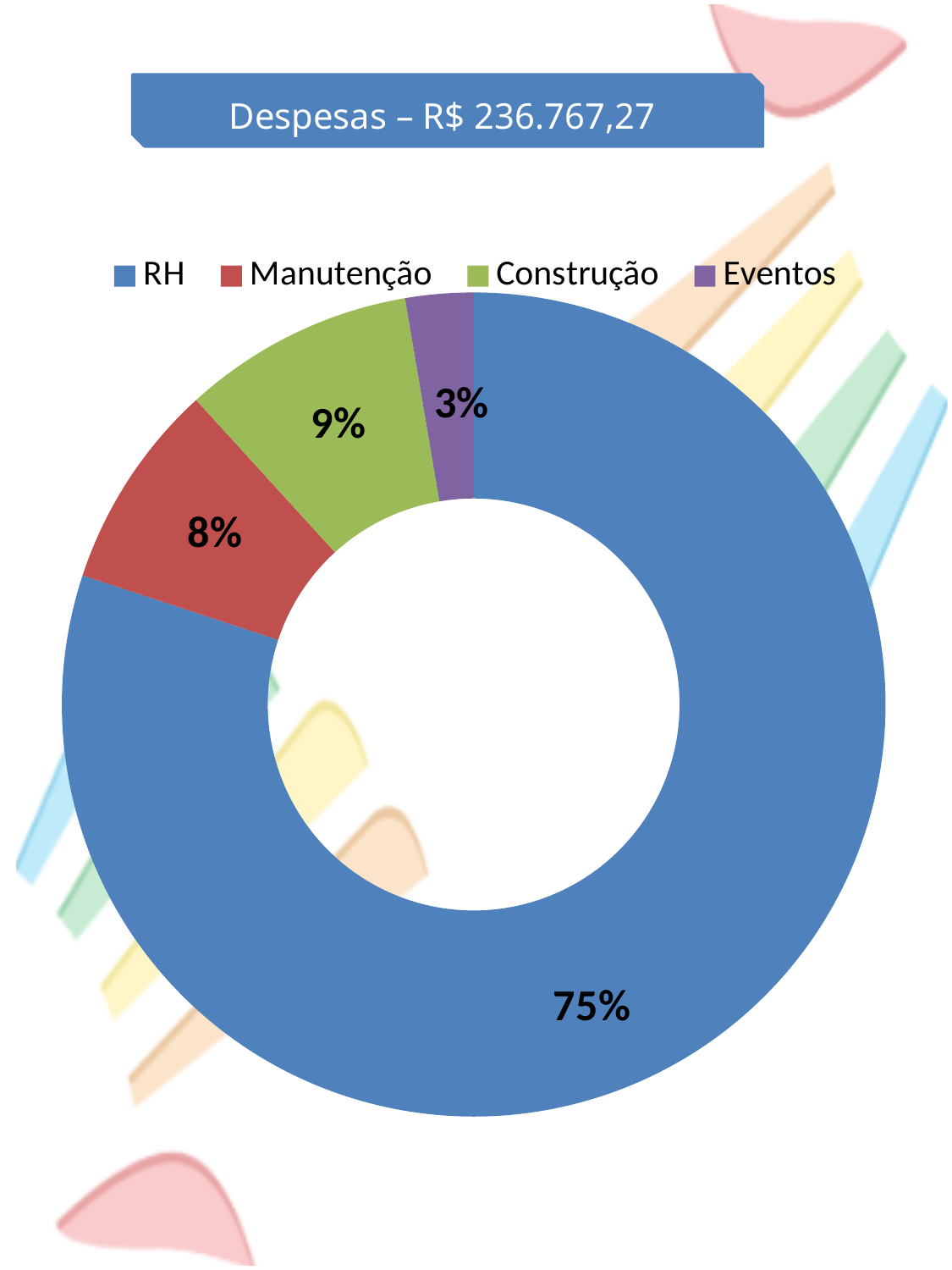
What share of expenses does RH account for? 75% What percentage is shown for Eventos? 3% What percentage is shown for Manutenção? 8% What total amount of expenses is stated in the chart title? R$ 236.767,27 Which category has the largest share of expenses? RH What is the difference in percentage points between RH and Eventos? 72% Which category has the smallest share of expenses? Eventos How many categories does the chart show? 4 What percentage is shown for Construção? 9% What is the difference in percentage points between Construção and Manutenção? 1% Which has a larger share, Construção or Manutenção? Construção What kind of chart is shown on the slide? Pie chart (doughnut)